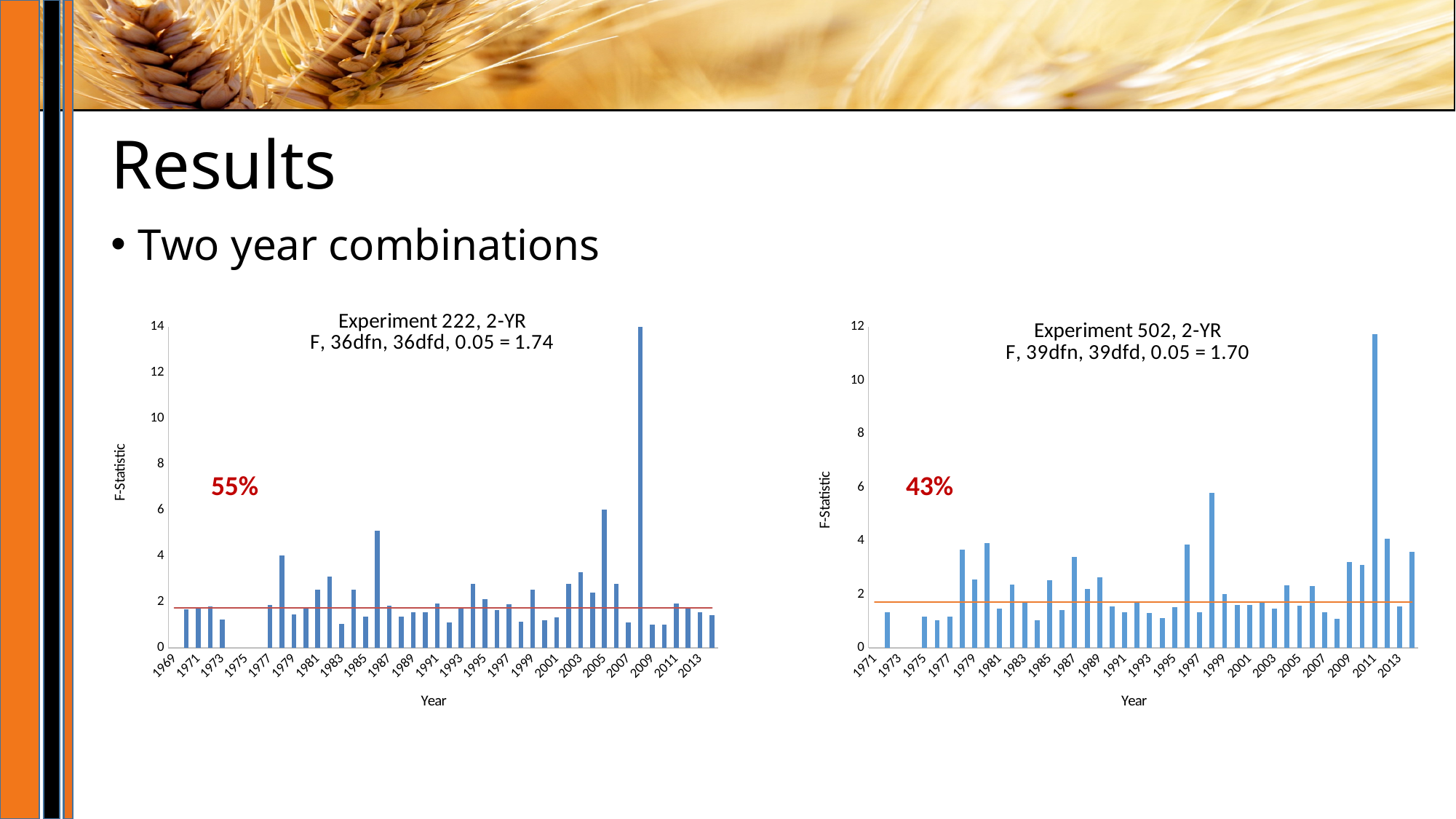
What is the y-axis label on the Experiment 502, 2-YR chart? F-Statistic In the Experiment 222, 2-YR chart, is the value for 2008 greater or less than 12? greater In the Experiment 222, 2-YR chart, which is larger, the value for 2006 or the value for 1986? 1986 In the Experiment 222, 2-YR chart, is the value for 1973 greater or less than 2? less In the Experiment 502, 2-YR chart, which year has the highest F-statistic? 2011 What percentage is printed in red on the Experiment 222, 2-YR chart? 55% In the Experiment 502, 2-YR chart, which is larger, the value for 1998 or the value for 1980? 1998 What kind of chart is the Experiment 222, 2-YR chart? bar chart In the Experiment 502, 2-YR chart, is the value for 2011 greater or less than 10? greater In the Experiment 222, 2-YR chart, which year has the highest F-statistic? 2008